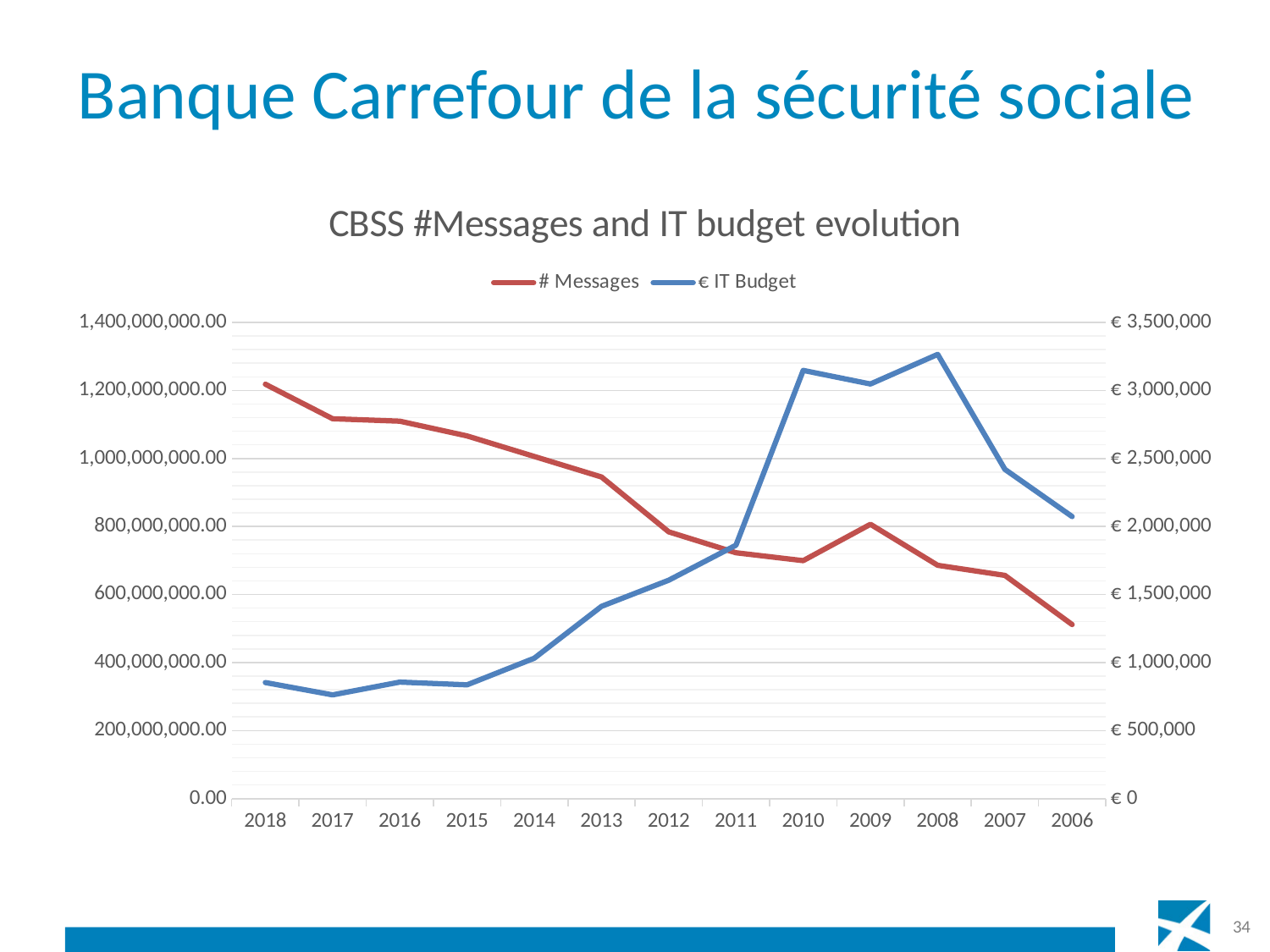
Which year has the larger # Messages value, 2013 or 2009? 2013 Which colour is used for the € IT Budget line? blue How many series does the legend list? 2 In which year is the # Messages value highest? 2018 In which year is the # Messages value lowest? 2006 Is the # Messages value for 2018 greater or less than 1,000,000,000.00? greater In which year is the € IT Budget value lowest? 2017 What kind of chart is shown on the slide? line chart How many years are shown along the x axis? 13 Moving along the x axis from 2018 to 2006, does the # Messages line rise or fall overall? fall Is the € IT Budget value for 2010 greater or less than € 3,000,000? greater What is the title of the chart? CBSS #Messages and IT budget evolution